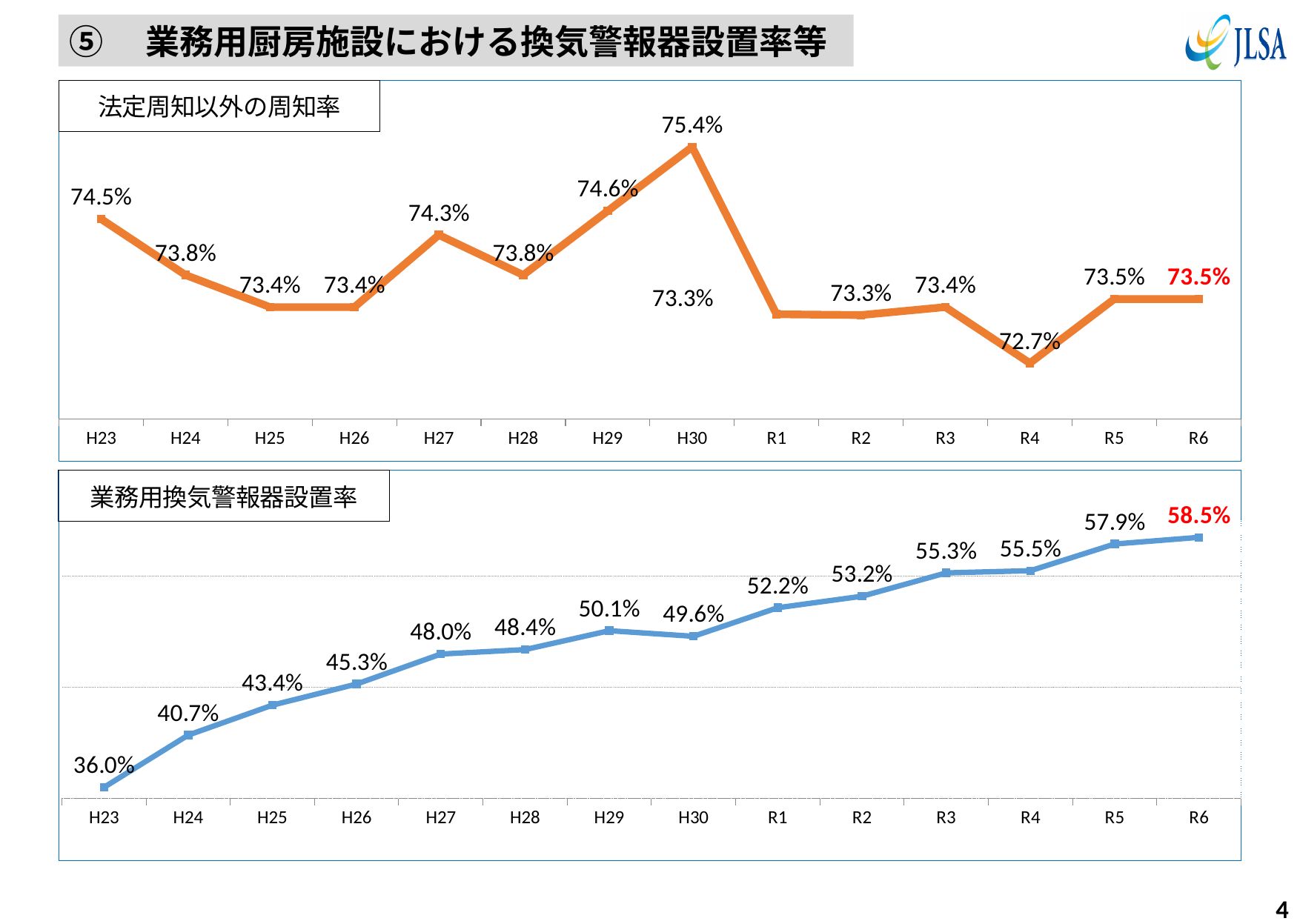
In the bottom chart (業務用換気警報器設置率), what is the value for R6? 58.5% How many years are plotted on the x axis of the bottom chart (業務用換気警報器設置率)? 14 In the top chart (法定周知以外の周知率), what is the difference between the H30 value and the R4 value? 2.7% In the bottom chart (業務用換気警報器設置率), do the values generally rise or fall from H23 to R6? rise In the top chart (法定周知以外の周知率), which year has the highest value? H30 In the bottom chart (業務用換気警報器設置率), which is larger, the value for H29 or the value for H30? H29 In the top chart (法定周知以外の周知率), which year has the lowest value? R4 In the top chart (法定周知以外の周知率), what is the value for R4? 72.7% What kind of chart is the top chart (法定周知以外の周知率)? line chart In the bottom chart (業務用換気警報器設置率), what is the difference between the R6 value and the H23 value? 22.5% In the top chart (法定周知以外の周知率), what is the value for H30? 75.4% In the bottom chart (業務用換気警報器設置率), what is the value for H23? 36.0%